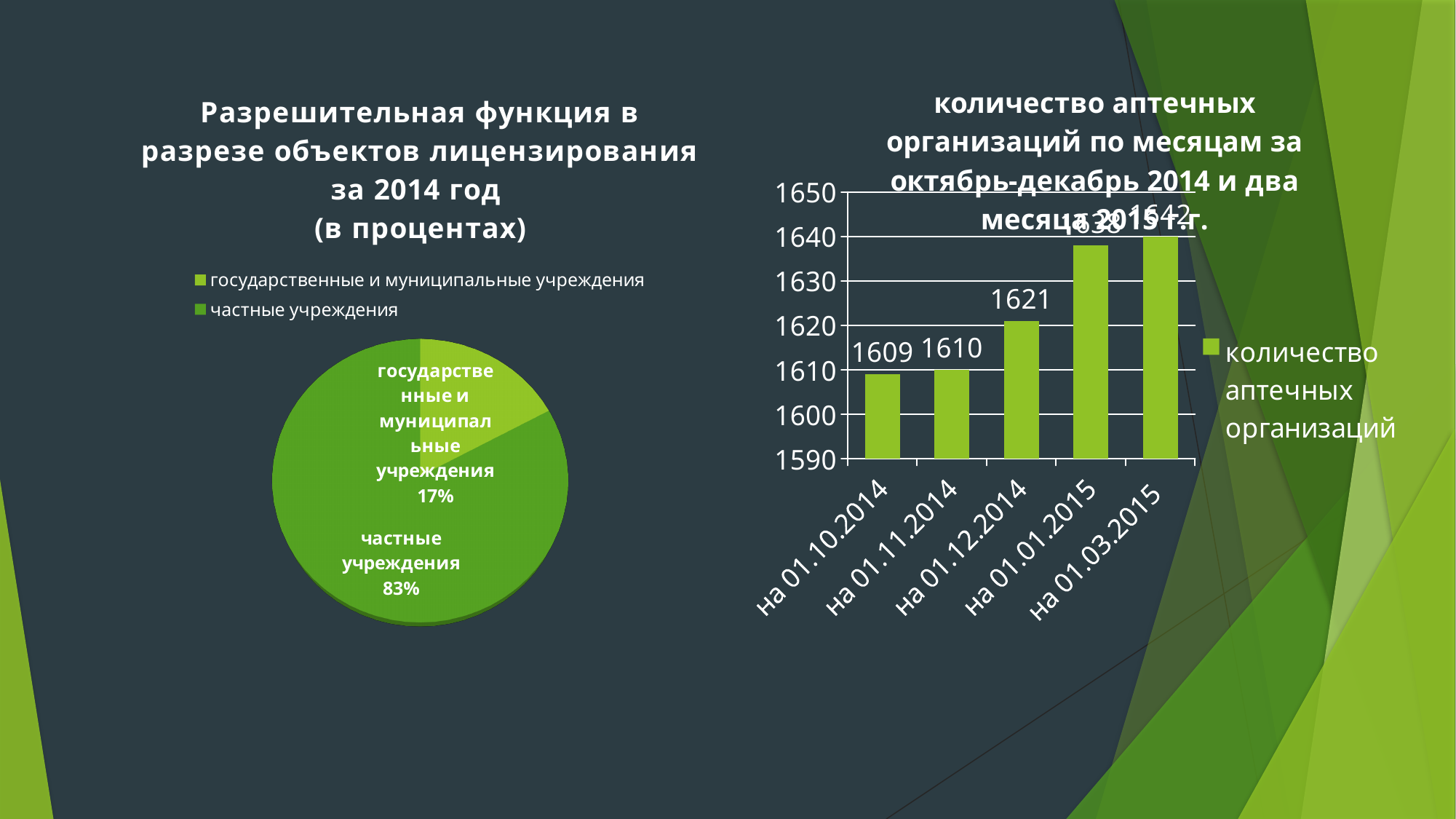
What kind of chart is the chart on the right? bar chart On the pie chart on the left, what share do государственные и муниципальные учреждения have? 17% On the pie chart on the left, what share do частные учреждения have? 83% On the bar chart on the right, what is the difference between the values for на 01.12.2014 and на 01.11.2014? 11 On the pie chart on the left, how many entries does the legend list? 2 On the bar chart on the right, do the values rise or fall from left to right along the x axis? rise On the pie chart on the left, what is the difference in percentage points between частные учреждения and государственные и муниципальные учреждения? 66 On the bar chart on the right, which date has the highest value? на 01.03.2015 On the bar chart on the right, is the value for на 01.01.2015 greater or less than 1630? greater On the pie chart on the left, which category has the larger share? частные учреждения On the bar chart on the right, what is the value for на 01.10.2014? 1609 On the bar chart on the right, what is the value for на 01.12.2014? 1621